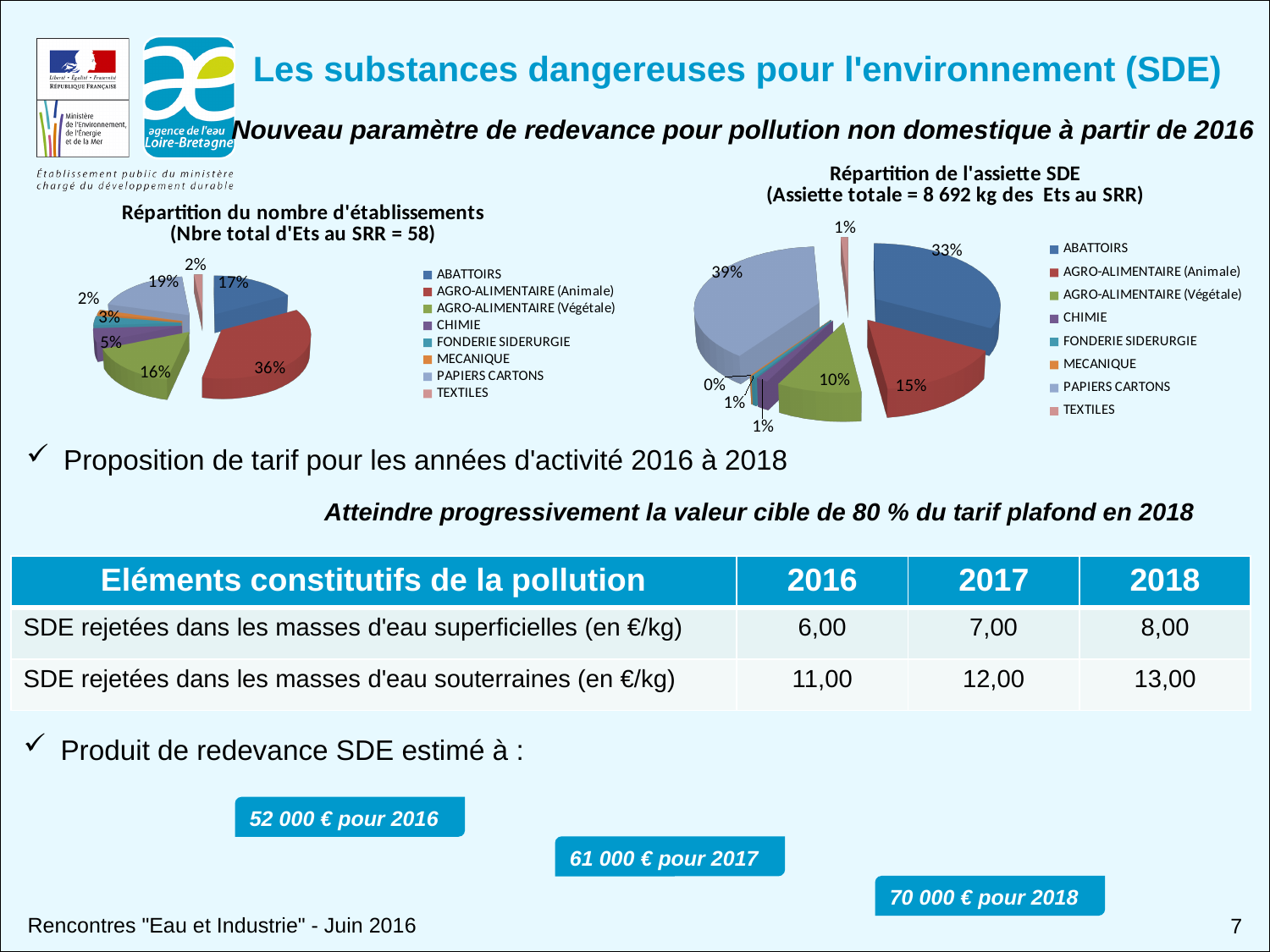
In the chart titled "Répartition du nombre d'établissements", what share of establishments is AGRO-ALIMENTAIRE (Animale)? 36% In the chart titled "Répartition de l'assiette SDE", what share is PAPIERS CARTONS? 39% How many categories does the legend of the chart titled "Répartition du nombre d'établissements" list? 8 What type of chart is the chart titled "Répartition de l'assiette SDE"? Pie chart In the chart titled "Répartition de l'assiette SDE", which is larger: AGRO-ALIMENTAIRE (Animale) or AGRO-ALIMENTAIRE (Végétale)? AGRO-ALIMENTAIRE (Animale) In the chart titled "Répartition de l'assiette SDE", which category has the largest share? PAPIERS CARTONS In the chart titled "Répartition de l'assiette SDE", which category has the smallest share? MECANIQUE In the chart titled "Répartition de l'assiette SDE", what share is ABATTOIRS? 33% In the chart titled "Répartition du nombre d'établissements", which category has the largest share? AGRO-ALIMENTAIRE (Animale) In the chart titled "Répartition du nombre d'établissements", what share is PAPIERS CARTONS? 19% In the chart titled "Répartition du nombre d'établissements", what is the difference between the ABATTOIRS share and the AGRO-ALIMENTAIRE (Végétale) share? 1% In the chart titled "Répartition de l'assiette SDE", what is the difference between the PAPIERS CARTONS share and the ABATTOIRS share? 6%